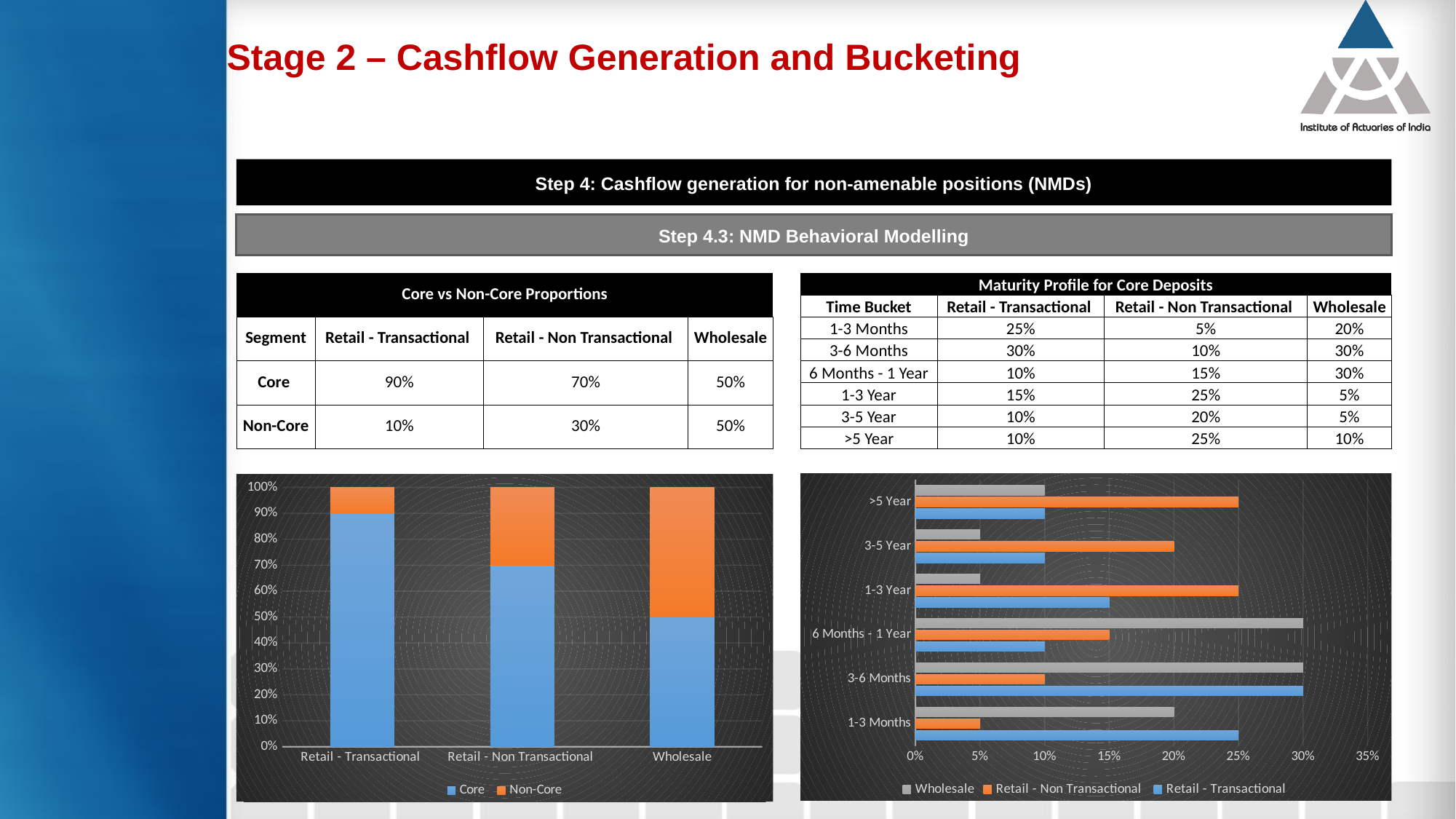
In the right chart, what is the Retail - Transactional value for 3-6 Months? 30% In the left chart, what is the Core value for Retail - Transactional? 90% What kind of chart is the left chart (Core vs Non-Core)? stacked bar chart How many time buckets are shown on the right chart? 6 In the left chart, which segment has the highest Core proportion? Retail - Transactional In the right chart, which time bucket has the lowest Wholesale value? 1-3 Year and 3-5 Year (both 5%) In the left chart, what is the difference between the Core values for Retail - Transactional and Retail - Non Transactional? 20% In the right chart, is the Wholesale value for 6 Months - 1 Year greater or less than 25%? greater How many series does the legend of the left chart list? 2 How many series does the legend of the right chart list? 3 What kind of chart is the right chart (Maturity Profile for Core Deposits)? bar chart In the left chart, what is the Non-Core value for Wholesale? 50%